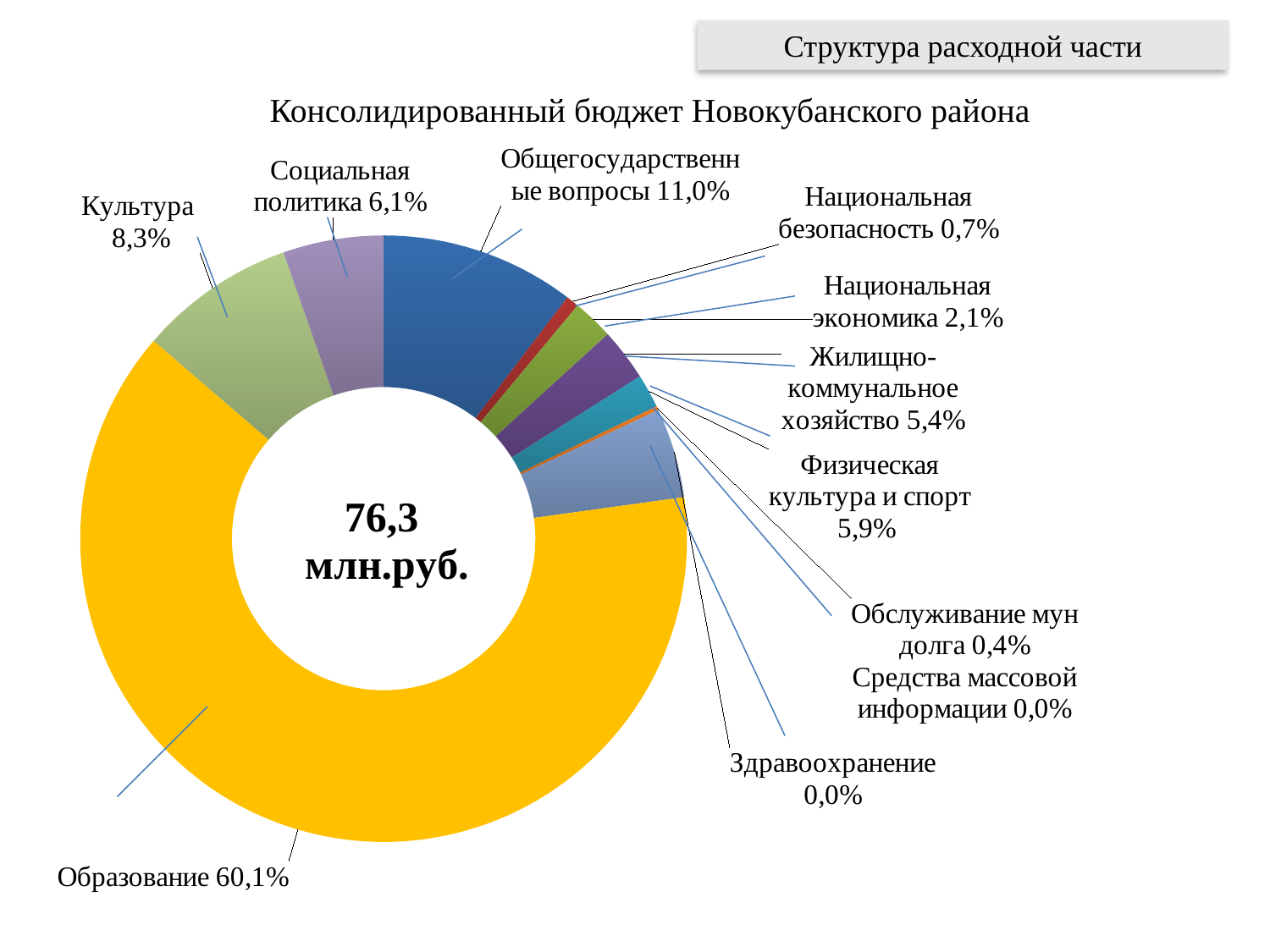
Which is larger, Культура or Социальная политика? Культура What total value is shown in the centre of the doughnut? 76,3 млн.руб. What share does Жилищно-коммунальное хозяйство have? 5,4% What share does Национальная безопасность have? 0,7% What is the difference between the shares of Образование and Общегосударственные вопросы? 49,1% What share does Образование have in the chart? 60,1% Which category has the largest share in the chart? Образование What kind of chart is shown on the slide? Doughnut (pie) chart What share does Общегосударственные вопросы have? 11,0% What is the title of the chart? Консолидированный бюджет Новокубанского района How many categories are labelled in the chart? 11 What is the difference between the shares of Физическая культура и спорт and Жилищно-коммунальное хозяйство? 0,5%